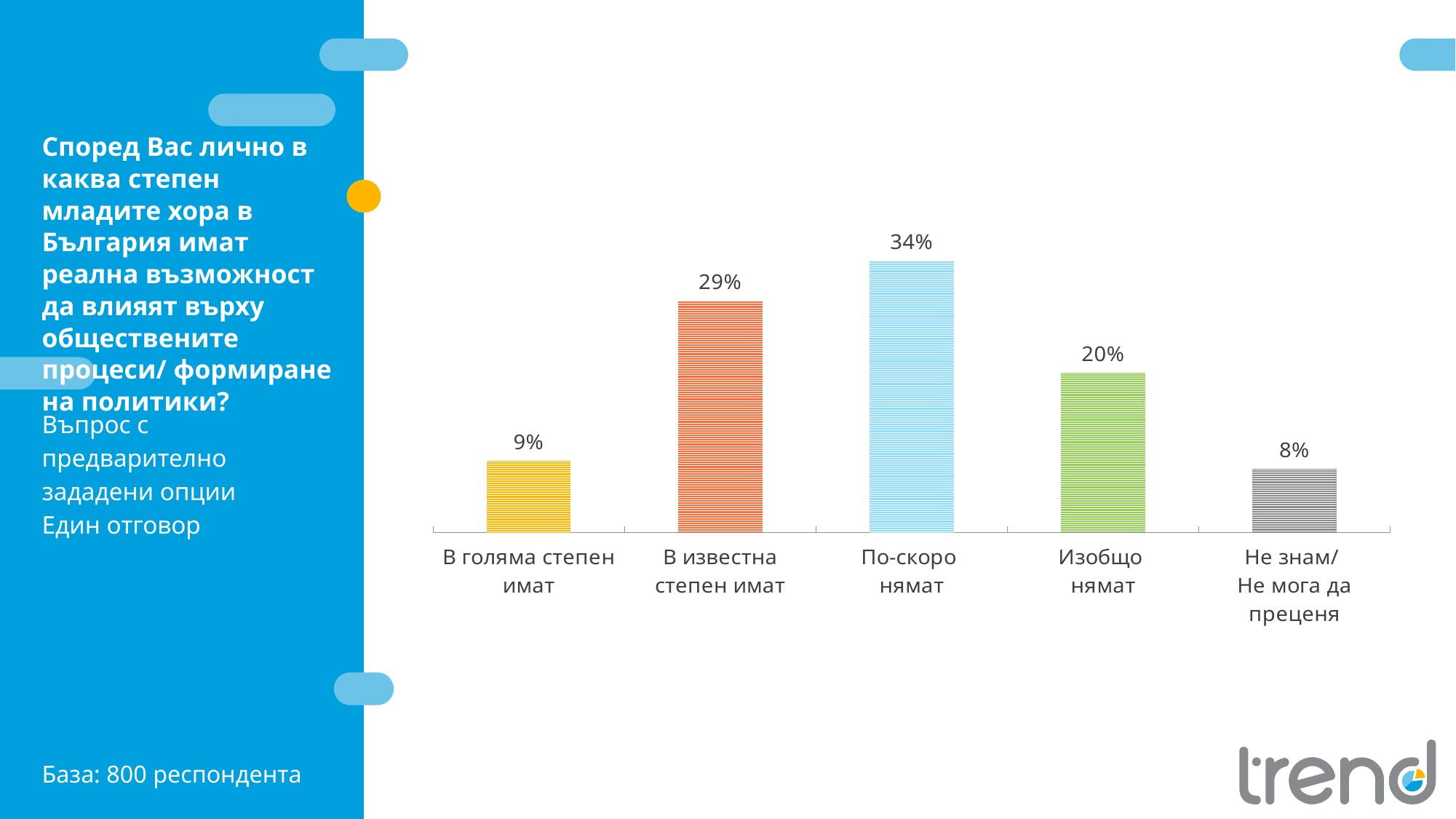
How many categories are shown in the chart? 5 What is the value for "Не знам/ Не мога да преценя"? 8% Which is larger, the value for "В известна степен имат" or the value for "Изобщо нямат"? В известна степен имат What is the difference between the values for "В известна степен имат" and "Изобщо нямат"? 9% How many respondents are in the base stated on the slide? 800 What is the combined value of "По-скоро нямат" and "Изобщо нямат"? 54% What kind of chart is shown on the slide? Bar chart What is the value for "По-скоро нямат"? 34% Which category has the highest value? По-скоро нямат Which category has the lowest value? Не знам/ Не мога да преценя What colour is the bar for "В известна степен имат"? Orange What is the value for "В голяма степен имат"? 9%